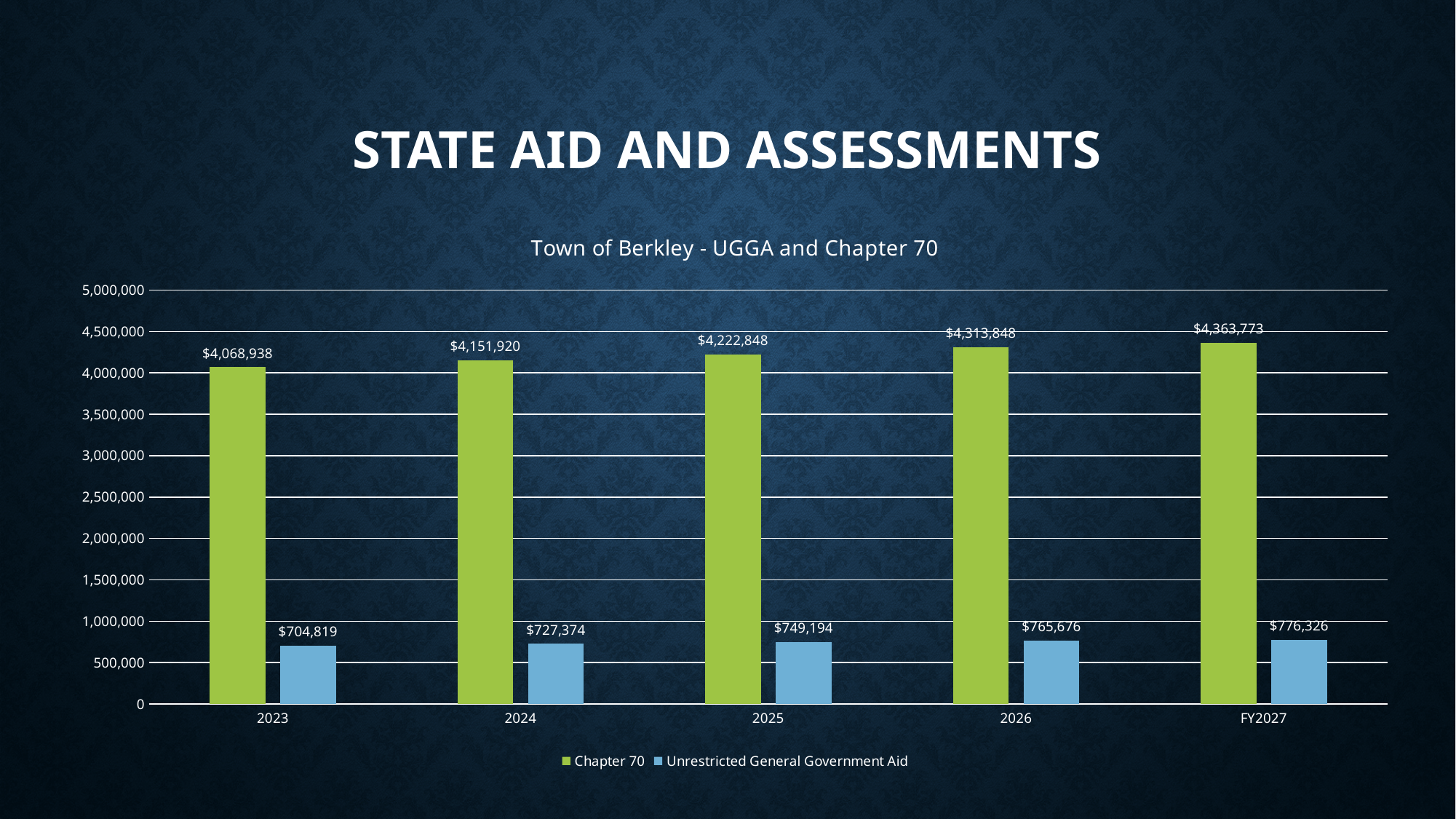
Which year has the lowest Chapter 70 value? 2023 Do the Chapter 70 values rise or fall from 2023 to FY2027? rise How many years are shown on the x axis? 5 Which year has the highest Unrestricted General Government Aid value? FY2027 How many series does the legend list? 2 What is the Chapter 70 value for FY2027? $4,363,773 Is the Unrestricted General Government Aid value for 2024 greater or less than 1,000,000? less What is the Chapter 70 value for 2023? $4,068,938 Which is larger in 2026: Chapter 70 or Unrestricted General Government Aid? Chapter 70 What is the difference between the Chapter 70 value for FY2027 and for 2023? $294,835 What is the difference between the Unrestricted General Government Aid value for FY2027 and for 2023? $71,507 What is the Unrestricted General Government Aid value for 2025? $749,194